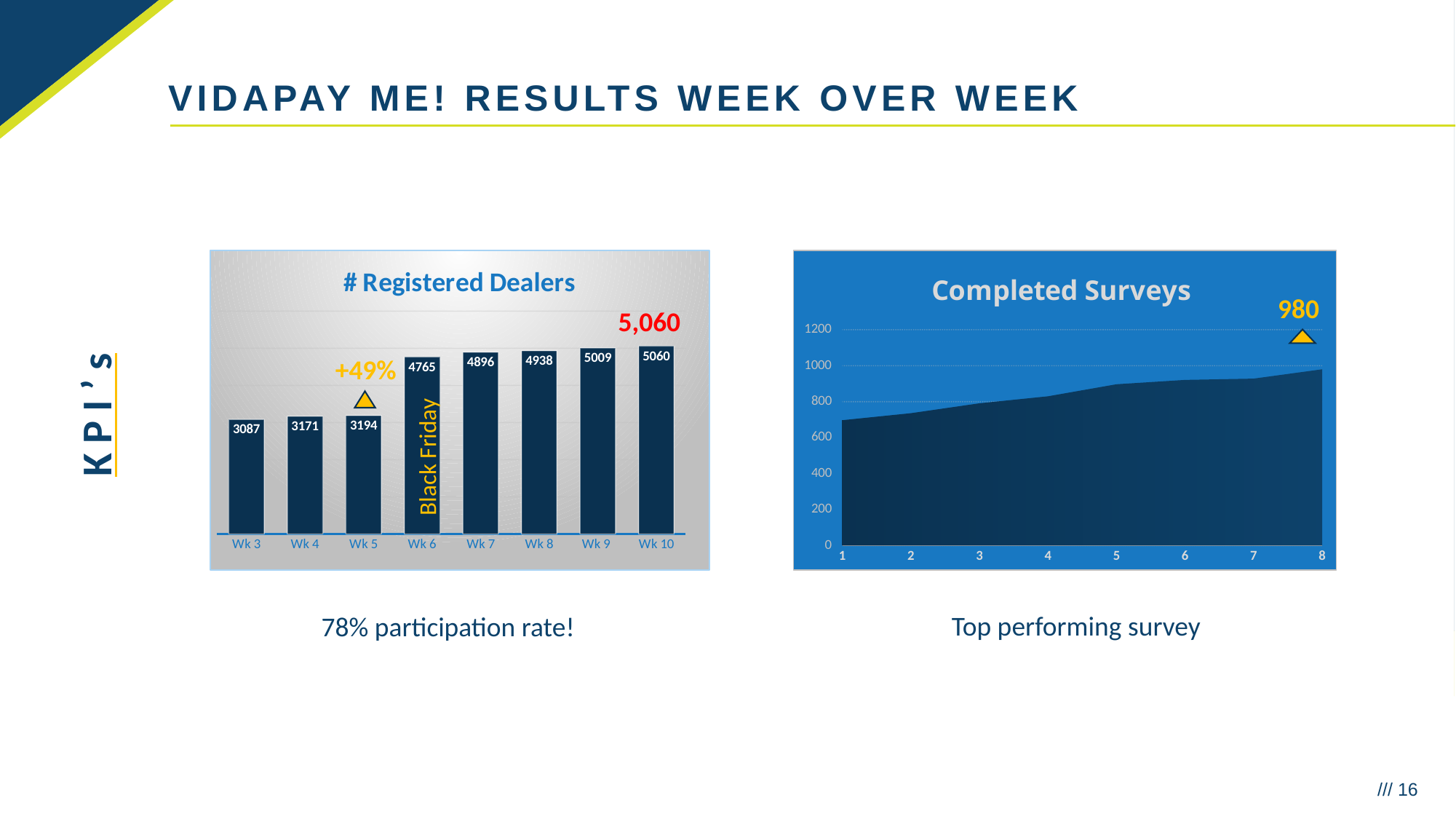
In the '# Registered Dealers' chart, which is larger, the value for Wk 7 or the value for Wk 8? Wk 8 What type of chart is the '# Registered Dealers' chart? bar chart In the '# Registered Dealers' chart, what is the value for Wk 6? 4765 In the '# Registered Dealers' chart, what is the value for Wk 3? 3087 In the '# Registered Dealers' chart, what label is written on the Wk 6 bar? Black Friday In the '# Registered Dealers' chart, which week has the lowest number of registered dealers? Wk 3 In the '# Registered Dealers' chart, which week has the highest number of registered dealers? Wk 10 In the 'Completed Surveys' chart, is the value at point 1 greater or less than 800? less In the 'Completed Surveys' chart, do the values rise or fall from point 1 to point 8? rise In the '# Registered Dealers' chart, what is the value for Wk 9? 5009 In the '# Registered Dealers' chart, what is the difference between the values for Wk 6 and Wk 5? 1571 How many weeks are shown in the '# Registered Dealers' chart? 8